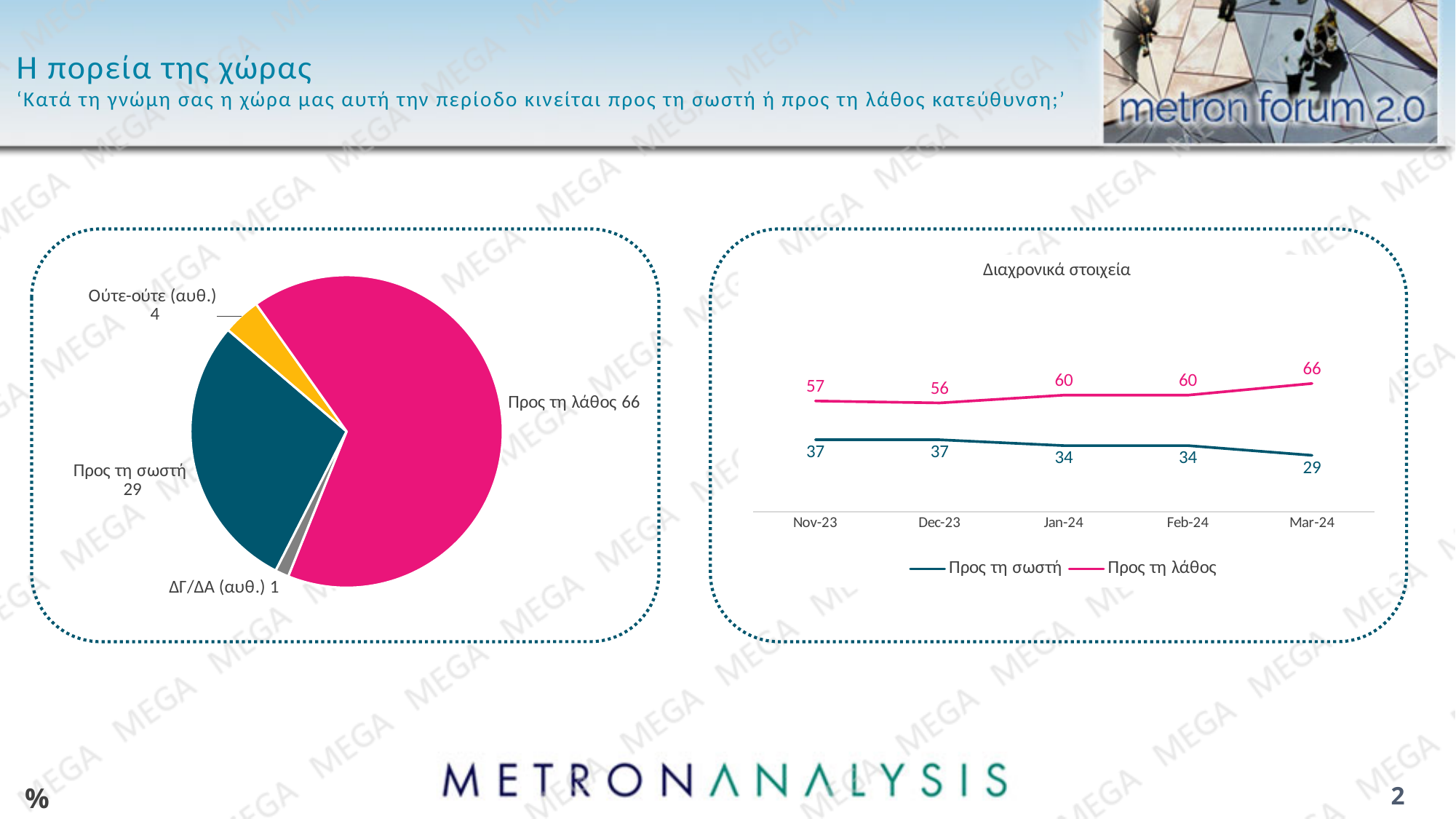
In the pie chart on the left, what is the difference between 'Προς τη λάθος' and 'Προς τη σωστή'? 37 In the 'Διαχρονικά στοιχεία' chart on the right, what is the value for 'Προς τη σωστή' in Jan-24? 34 In the pie chart on the left, what is the value for 'Προς τη λάθος'? 66 What kind of chart is the 'Διαχρονικά στοιχεία' chart on the right? line chart In the pie chart on the left, which category has the smallest slice? ΔΓ/ΔΑ (αυθ.) In the 'Διαχρονικά στοιχεία' chart on the right, how many series does the legend list? 2 In the 'Διαχρονικά στοιχεία' chart on the right, does 'Προς τη σωστή' rise or fall from Nov-23 to Mar-24? fall In the pie chart on the left, what is the value for 'Προς τη σωστή'? 29 In the 'Διαχρονικά στοιχεία' chart on the right, what is the value for 'Προς τη λάθος' in Mar-24? 66 In the 'Διαχρονικά στοιχεία' chart on the right, in which month is 'Προς τη σωστή' lowest? Mar-24 In the pie chart on the left, how many slices are there? 4 In the 'Διαχρονικά στοιχεία' chart on the right, what is the difference between 'Προς τη λάθος' and 'Προς τη σωστή' in Dec-23? 19